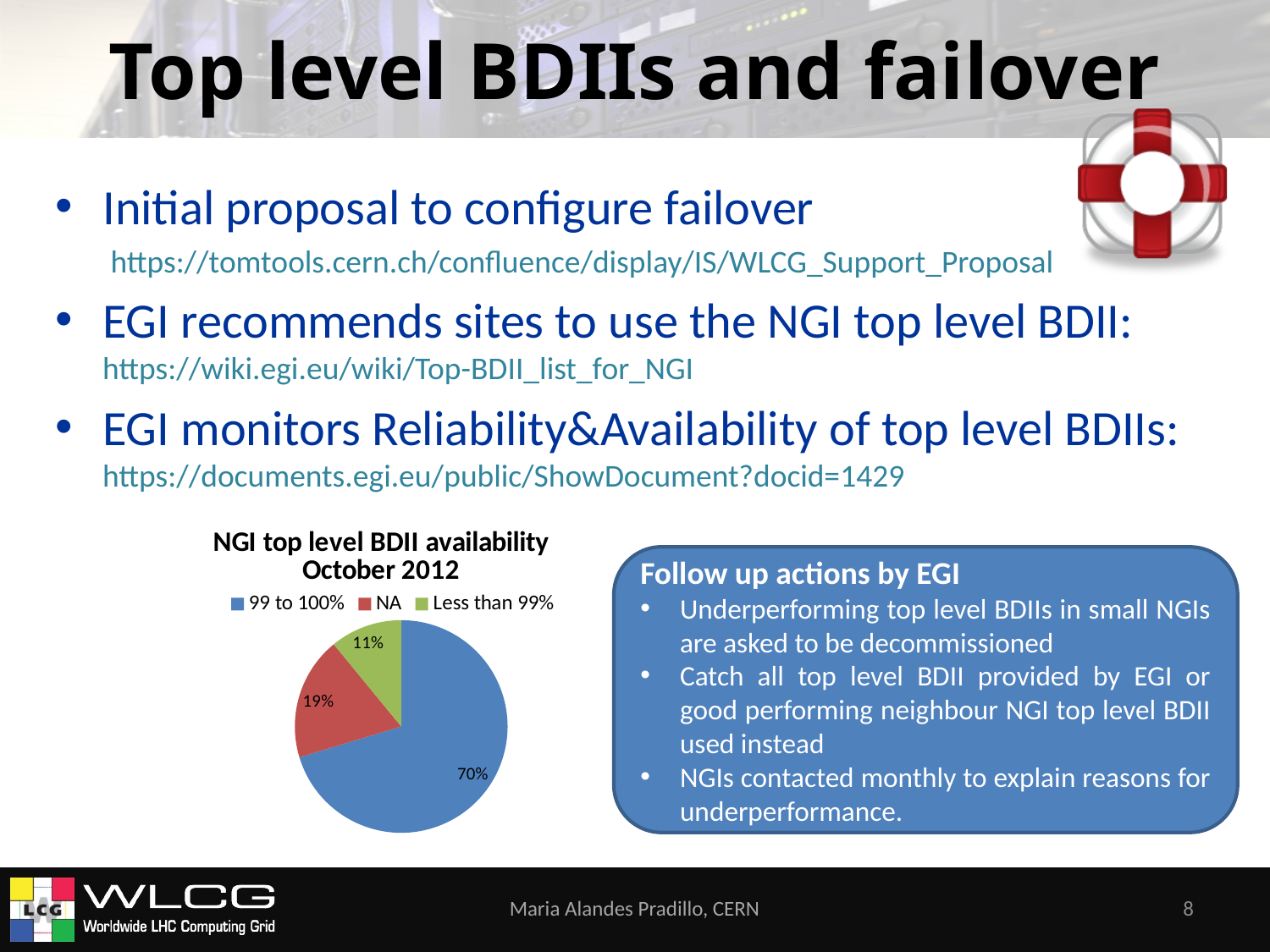
Which category has the largest slice of the pie? 99 to 100% What share of the pie does the 'Less than 99%' slice represent? 11% What share of the pie does the 'NA' slice represent? 19% Which slice is larger, 'NA' or 'Less than 99%'? NA What kind of chart is shown on the slide? pie chart Which category has the smallest slice of the pie? Less than 99% What share of the pie does the '99 to 100%' slice represent? 70% How many slices does the pie chart have? 3 What is the title of the chart? NGI top level BDII availability October 2012 What colour is the '99 to 100%' slice? blue How many entries does the legend list? 3 What is the difference in percentage points between the '99 to 100%' slice and the 'NA' slice? 51